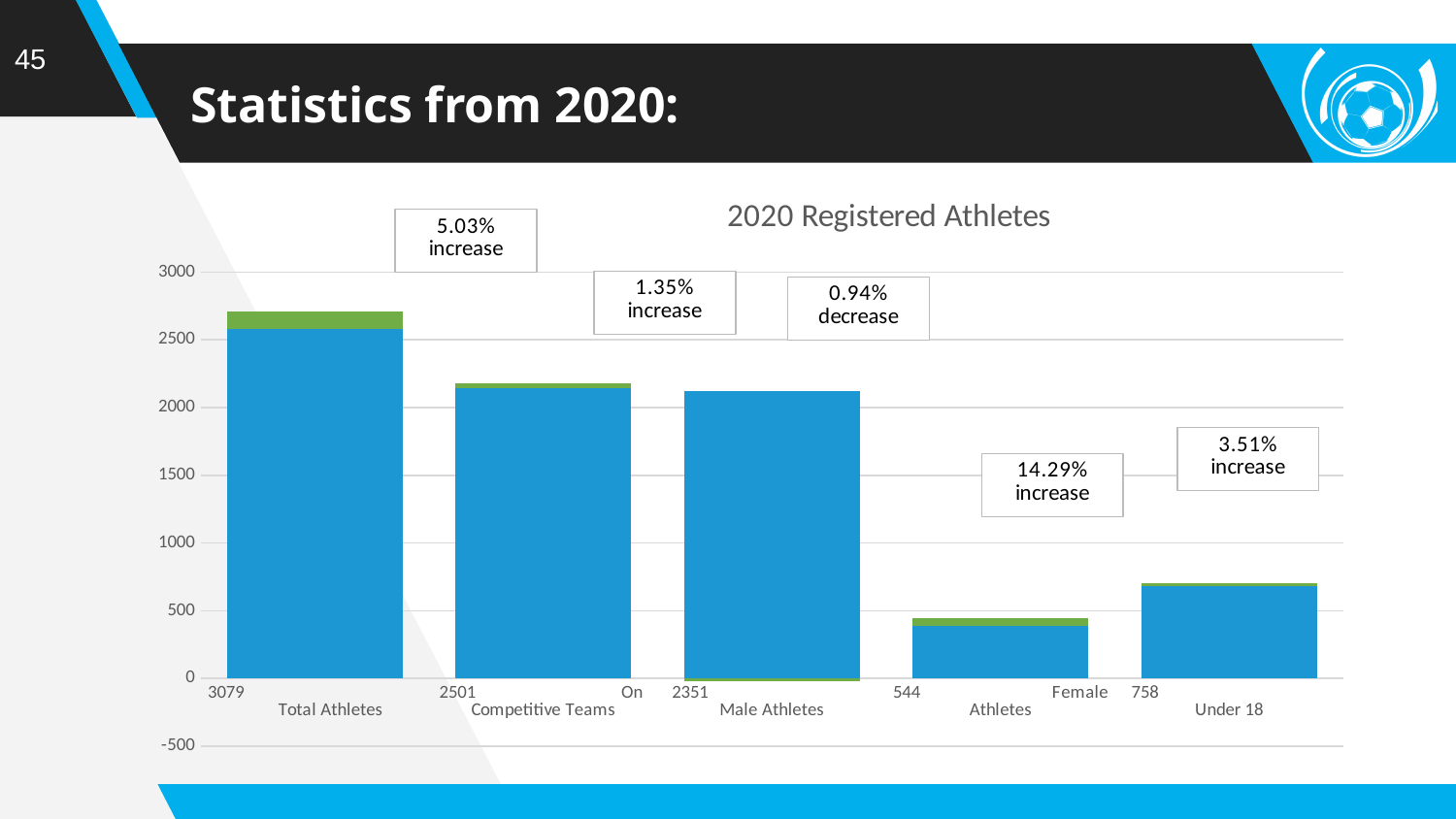
What kind of chart is shown on the slide? bar chart Is the bar for Under 18 greater or less than 1000? less Which bar is taller, Under 18 or Female Athletes? Under 18 Is the bar for Total Athletes greater or less than 2500? greater What percentage change is annotated above the Female Athletes bar? 14.29% increase What is the title of the chart? 2020 Registered Athletes Is the bar for Male Athletes greater or less than 2000? greater Which category has the tallest bar in the chart? Total Athletes Which category has the shortest bar in the chart? Female Athletes Which bar is taller, Competitive Teams or Male Athletes? Competitive Teams How many categories are shown on the x axis of the chart? 5 Do the bar heights generally rise or fall from Total Athletes to Female Athletes along the x axis? fall